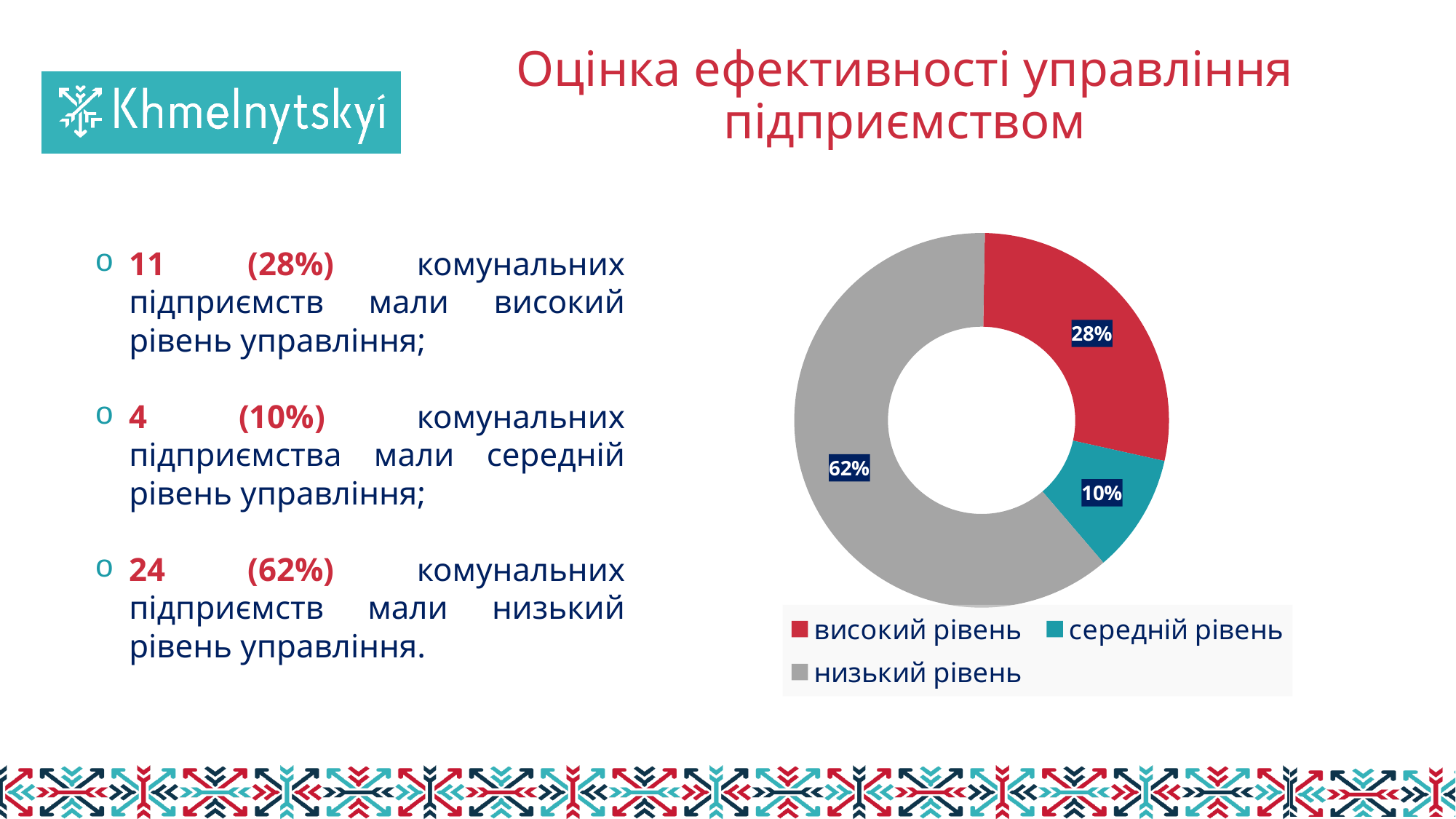
What share of the doughnut chart does the 'низький рівень' slice represent? 62% What is the difference in percentage points between the 'низький рівень' and 'високий рівень' slices? 34 What share of the doughnut chart does the 'високий рівень' slice represent? 28% What colour is the 'середній рівень' slice in the chart? teal What colour is the 'низький рівень' slice in the chart? grey What type of chart is shown on the slide? doughnut chart How many categories does the chart show? 3 Which category has the largest slice in the chart? низький рівень What share of the doughnut chart does the 'середній рівень' slice represent? 10% Which category has the smallest slice in the chart? середній рівень Which slice is larger: 'високий рівень' or 'середній рівень'? високий рівень What is the difference in percentage points between the 'високий рівень' and 'середній рівень' slices? 18